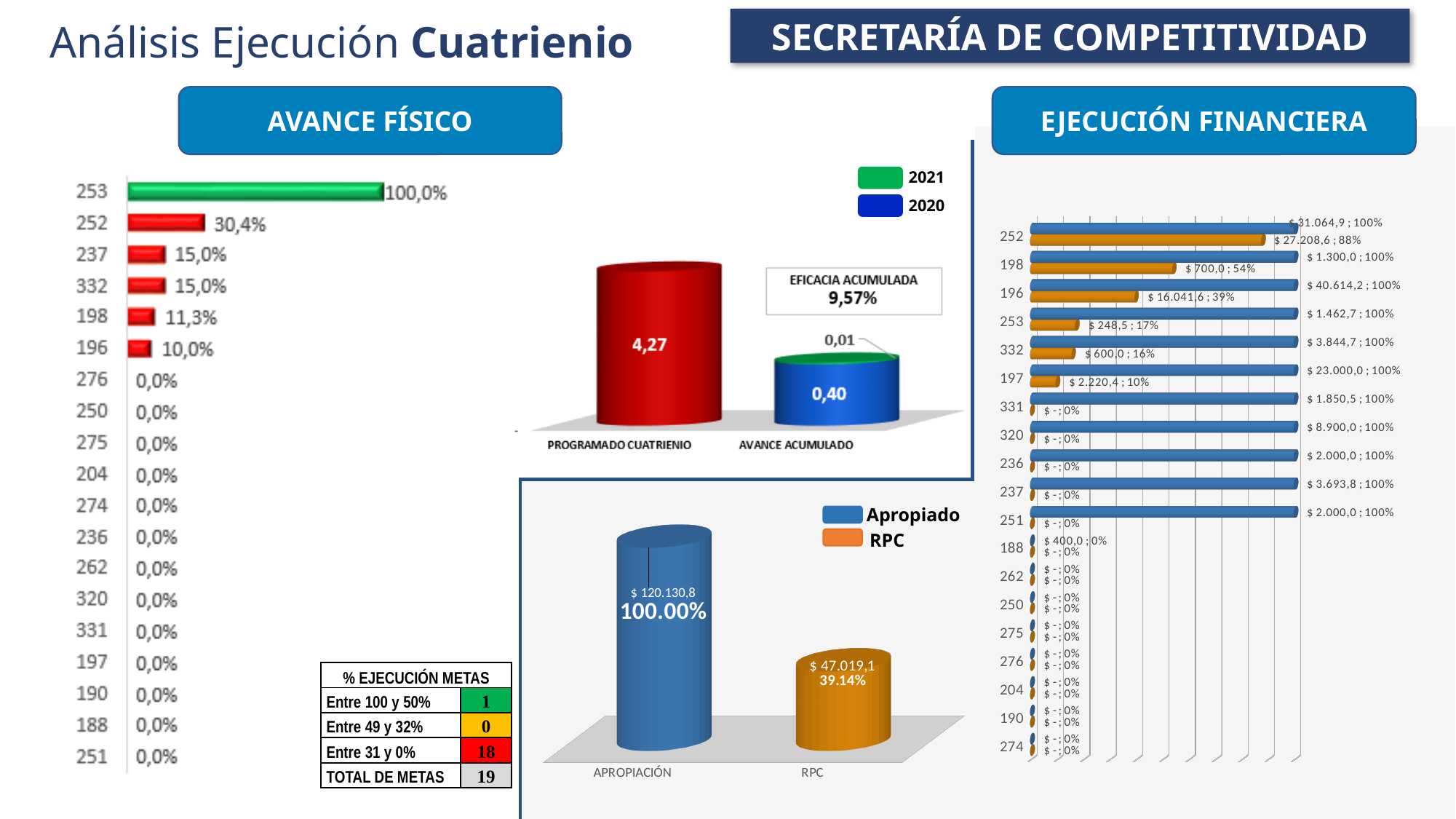
In the Programado Cuatrienio vs Avance Acumulado chart in the middle, what is the value for Programado Cuatrienio? 4,27 In the Avance Físico bar chart on the left, what is the value for category 252? 30,4% In the Ejecución Financiera chart on the right, how many series does the legend list? 2 In the Avance Físico bar chart on the left, what is the difference between the values for 252 and 198? 19,1% In the Apropiación vs RPC chart at the bottom middle, what is the value for RPC? $ 47.019,1 In the Avance Físico bar chart on the left, how many categories are plotted? 19 In the Programado Cuatrienio vs Avance Acumulado chart in the middle, what is the Eficacia Acumulada shown? 9,57% In the Ejecución Financiera chart on the right, what is the RPC value for category 252? $ 27.208,6 ; 88% In the Apropiación vs RPC chart at the bottom middle, what percentage is shown for RPC? 39.14% In the Avance Físico bar chart on the left, which category has the highest value? 253 In the Avance Físico bar chart on the left, what is the value for category 253? 100,0% In the Ejecución Financiera chart on the right, what is the Apropiado value for category 196? $ 40.614,2 ; 100%